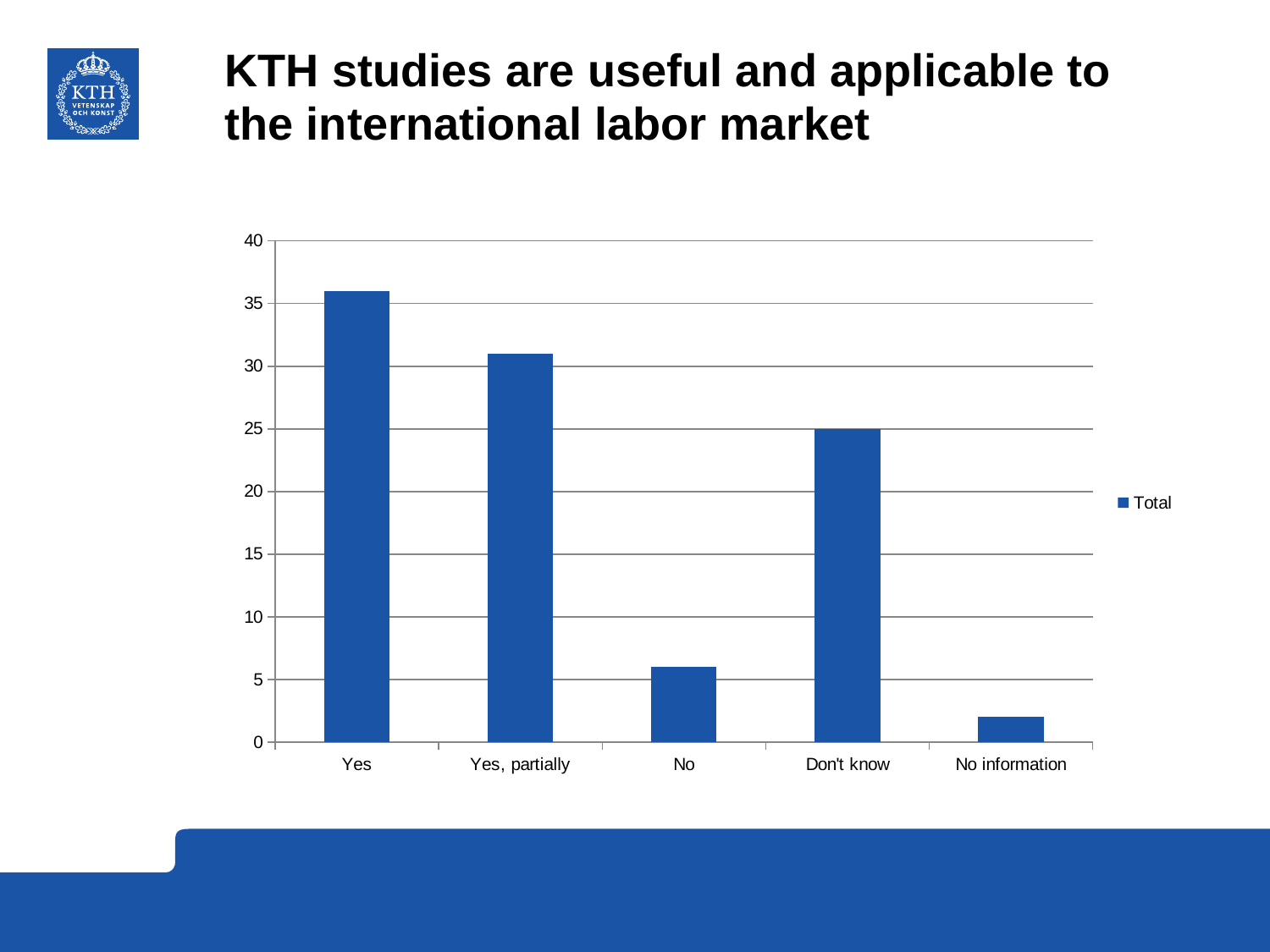
Which is larger, the value for No or the value for No information? No Is the value for Yes, partially greater or less than 30? greater What kind of chart is shown on the slide? bar chart Which is larger, the value for Yes, partially or the value for Don't know? Yes, partially Which category has the highest value? Yes How many series does the legend list? 1 How many categories are shown on the x axis? 5 Is the value for Yes greater or less than 35? greater Which category has the lowest value? No information Is the value for No greater or less than 10? less What is the name of the series shown in the legend? Total What is the value for Don't know? 25